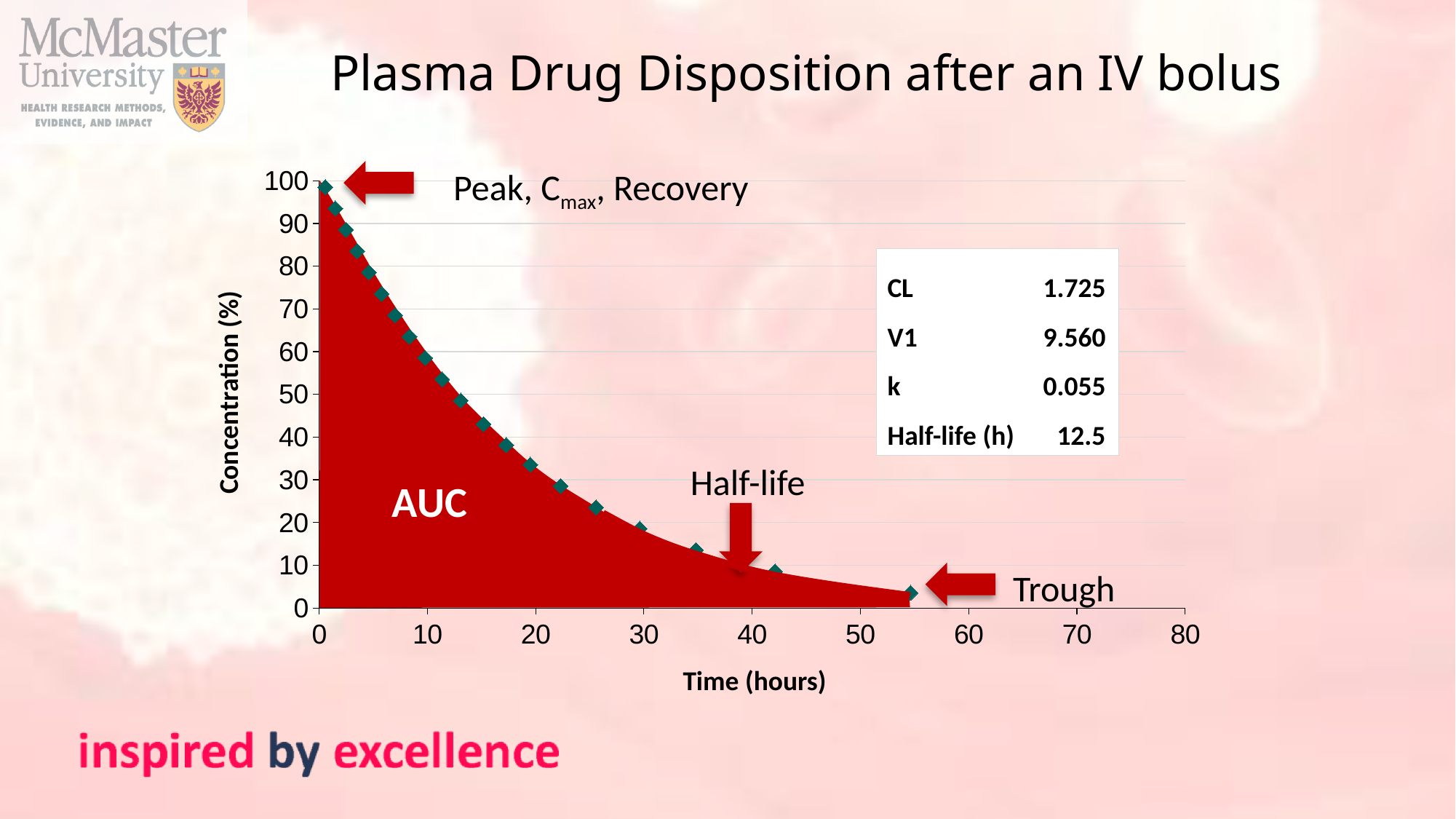
Is the concentration at 10 hours greater or less than 50? greater Is the concentration at 50 hours greater or less than 10? less Does the concentration rise or fall as time increases along the x axis? fall What kind of chart is shown on the slide? area chart Is the concentration at 10 hours greater or less than 70? less What is the highest value shown on the x axis (Time in hours)? 80 At which time shown on the x axis is the concentration highest? 0 What is the label of the y axis? Concentration (%) What is the title of the chart? Plasma Drug Disposition after an IV bolus Is the concentration higher at 10 hours or at 30 hours? 10 hours